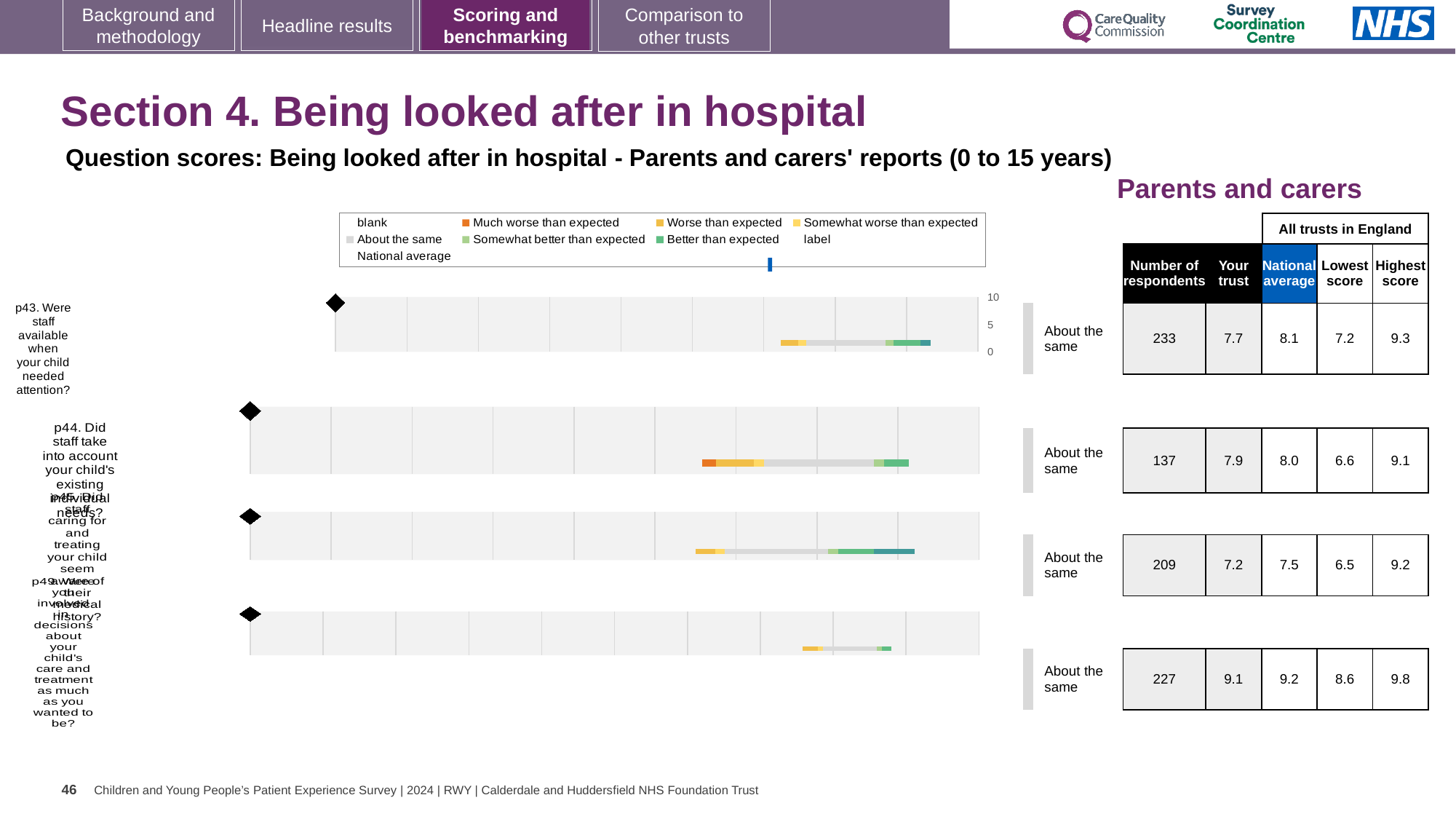
What kind of chart is used to show the distribution of trust scores for each question on this slide? bar chart What benchmark category is shown for every question on this slide? About the same Which question row has the lowest 'Your trust' score? p45 (7.2) What is the highest score across all trusts in England for p45 (the third row)? 9.2 How many questions (rows) are plotted on the slide? 4 What is the difference between the national average and the 'Your trust' score for p43? 0.4 In the legend, which colour represents 'Much worse than expected'? orange Which question row has the highest 'Your trust' score? p49 (9.1) For p43, what is the national average score shown in the table? 8.1 How many respondents are listed for p44 (Did staff take into account your child's existing individual needs?)? 137 Is the 'Your trust' score for p49 (the bottom row) larger or smaller than the national average for that question? smaller For p43 (Were staff available when your child needed attention?), what is the 'Your trust' score shown in the table? 7.7